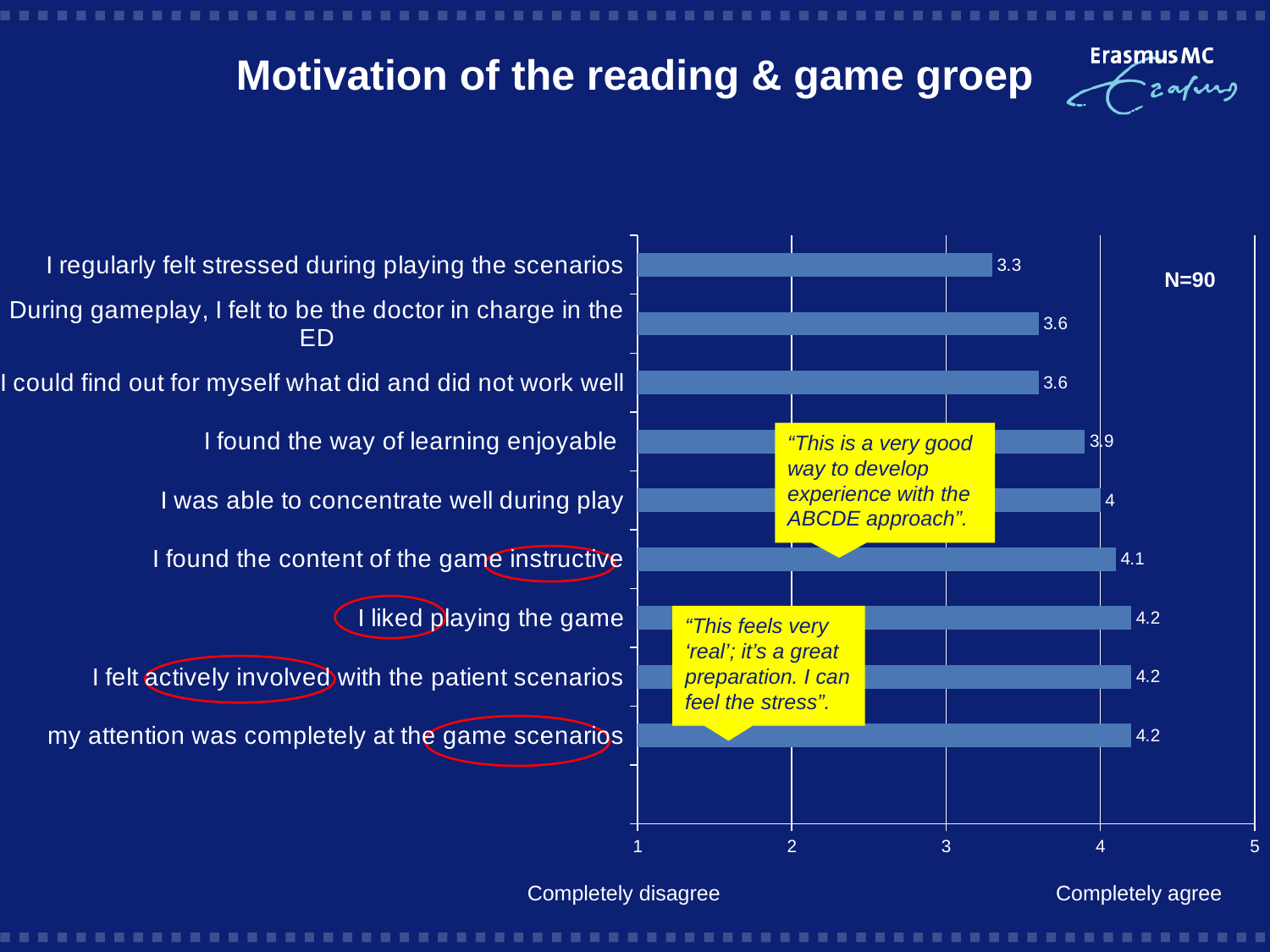
What kind of chart is shown on the slide? bar chart Which has a larger value: "I found the way of learning enjoyable" or "During gameplay, I felt to be the doctor in charge in the ED"? I found the way of learning enjoyable What is the value for "I found the content of the game instructive"? 4.1 Is the value for "I regularly felt stressed during playing the scenarios" greater or less than 4? less What is the value for "I found the way of learning enjoyable"? 3.9 What sample size (N) is shown on the chart? N=90 What is the value for "I regularly felt stressed during playing the scenarios"? 3.3 What is the highest value shown on the chart? 4.2 Which statement has the lowest value? I regularly felt stressed during playing the scenarios How many statements are plotted on the chart? 9 What is the value for "I was able to concentrate well during play"? 4 What is the difference between the value for "I liked playing the game" and the value for "I regularly felt stressed during playing the scenarios"? 0.9